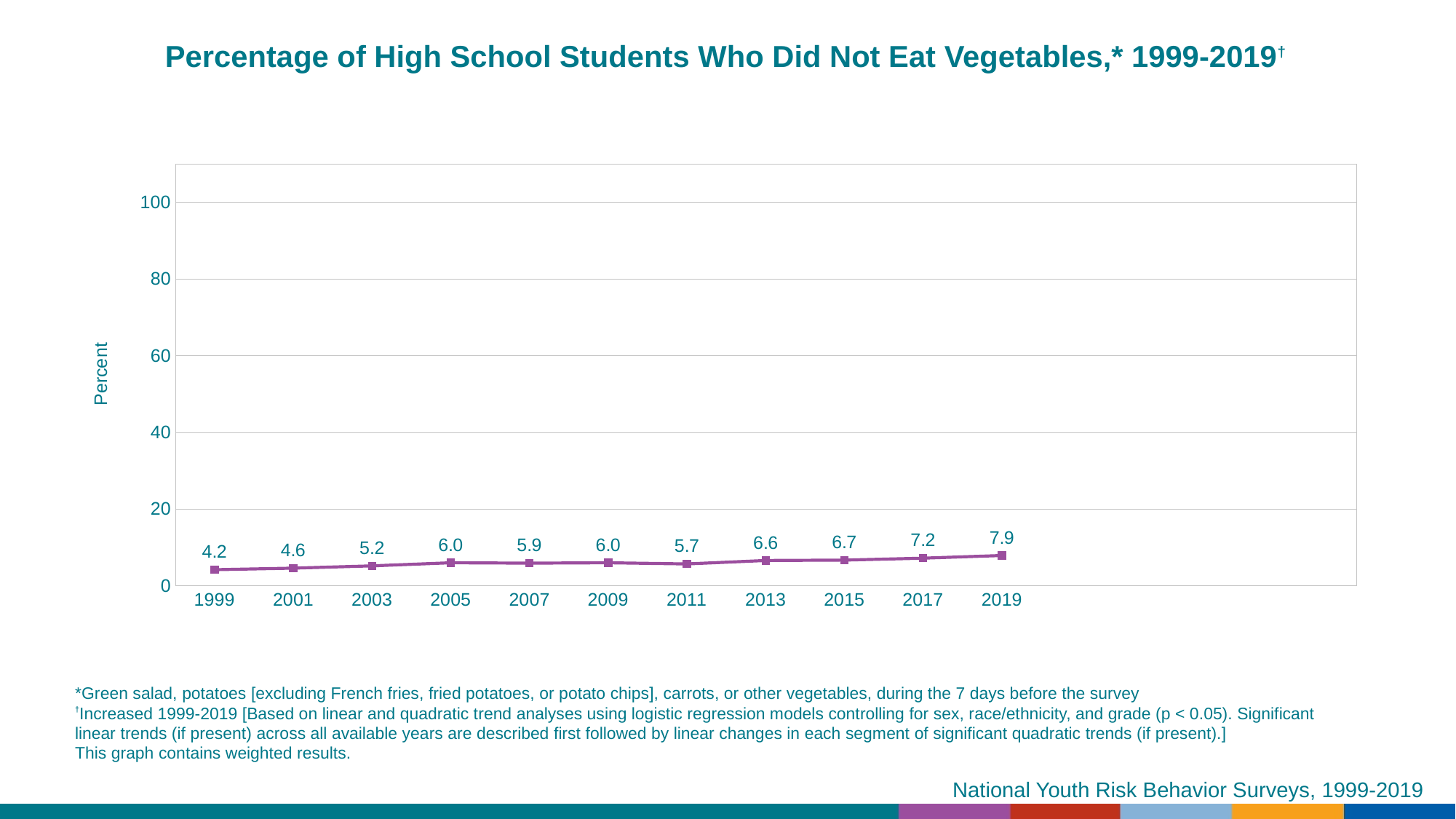
What kind of chart is shown on the slide? line chart Which year has the highest percentage of students who did not eat vegetables? 2019 Is the value for 2019 greater or less than 20? less What is the value plotted for 2011? 5.7 By how much did the percentage change from 1999 to 2019? 3.7 What is the difference between the values for 2005 and 2007? 0.1 Which year has the larger value, 2013 or 2011? 2013 What is the value plotted for 2019? 7.9 Which year has the lowest percentage of students who did not eat vegetables? 1999 What percentage of high school students did not eat vegetables in 1999? 4.2 Overall, does the percentage rise or fall from 1999 to 2019? rise How many years are plotted on the chart? 11